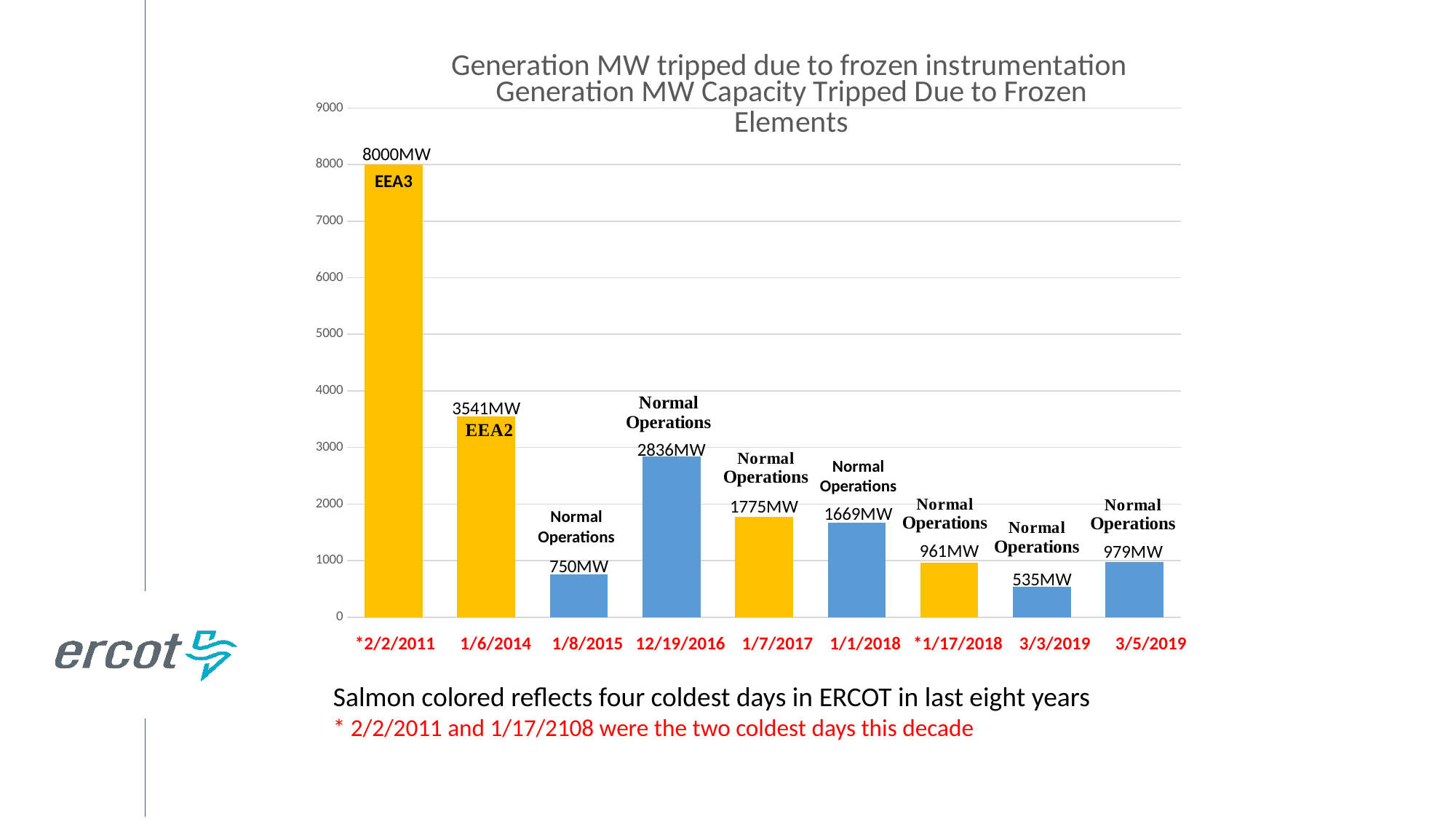
What kind of chart is this? Bar chart What label is printed on the bar for 1/6/2014? EEA2 What value is shown for 3/3/2019? 535MW What is the difference between the values for 2/2/2011 and 1/6/2014? 4459MW Which date has the lowest generation MW tripped? 3/3/2019 What is the difference between the values for 3/5/2019 and 3/3/2019? 444MW What value is shown for 1/17/2018? 961MW How many dates are shown on the x axis? 9 Which date has the highest generation MW tripped? 2/2/2011 What value is shown for 12/19/2016? 2836MW Which is larger, the value for 1/7/2017 or the value for 1/1/2018? 1/7/2017 What value is shown for 2/2/2011? 8000MW